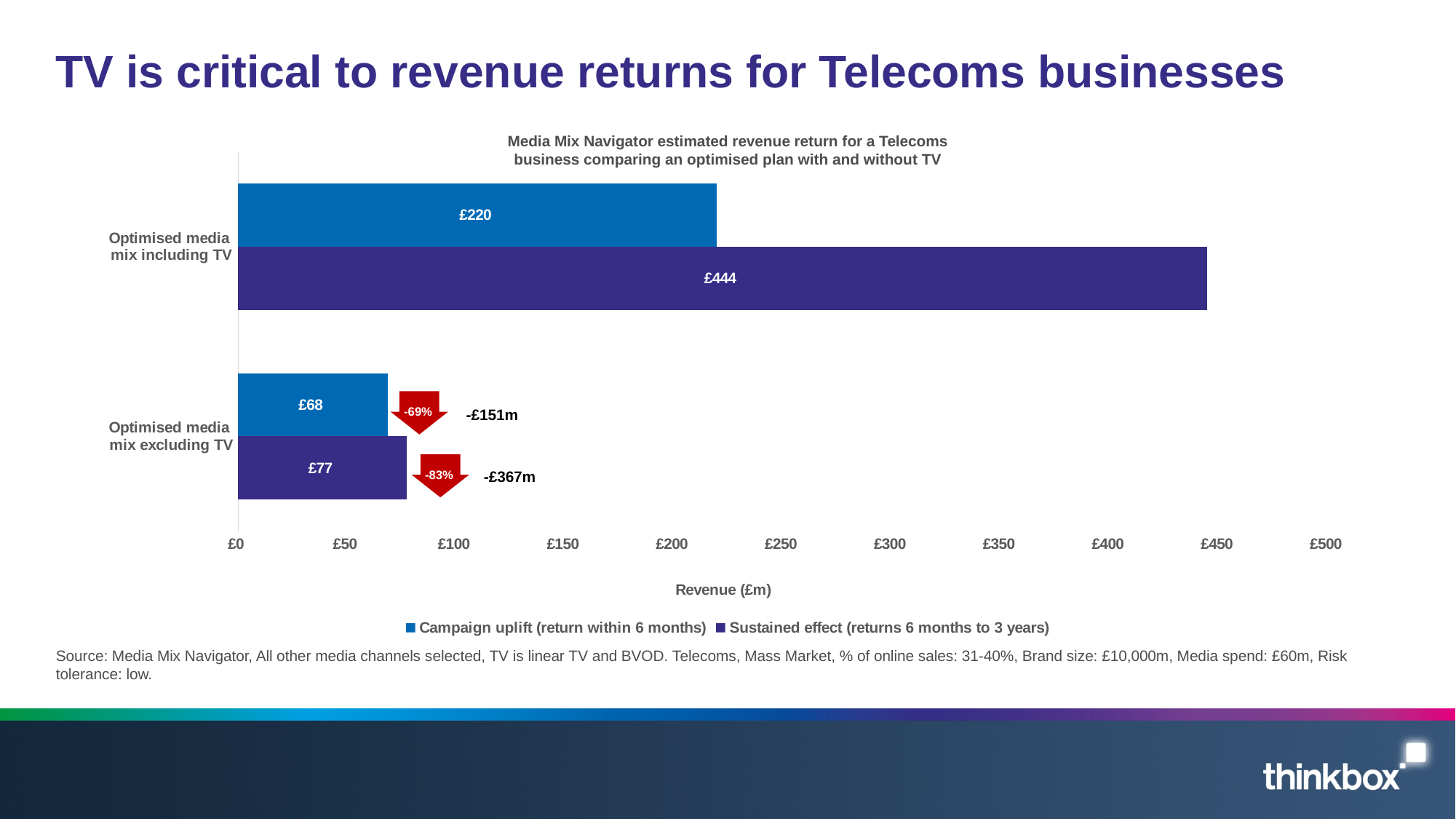
How many series does the legend list? 2 Which is larger: the Campaign uplift for the mix including TV or the Sustained effect for the mix including TV? Sustained effect for the mix including TV What kind of chart is shown on the slide? Bar chart Which category has the highest Sustained effect value? Optimised media mix including TV What is the difference between the Sustained effect values for the media mix including TV and excluding TV? £367 What is the difference between the Campaign uplift values for the media mix including TV and excluding TV? £152 What is the label of the x axis? Revenue (£m) What is the Sustained effect value for the Optimised media mix excluding TV? £77 What is the Campaign uplift value for the Optimised media mix including TV? £220 What is the Campaign uplift value for the Optimised media mix excluding TV? £68 What is the Sustained effect value for the Optimised media mix including TV? £444 Which category has the lowest Campaign uplift value? Optimised media mix excluding TV